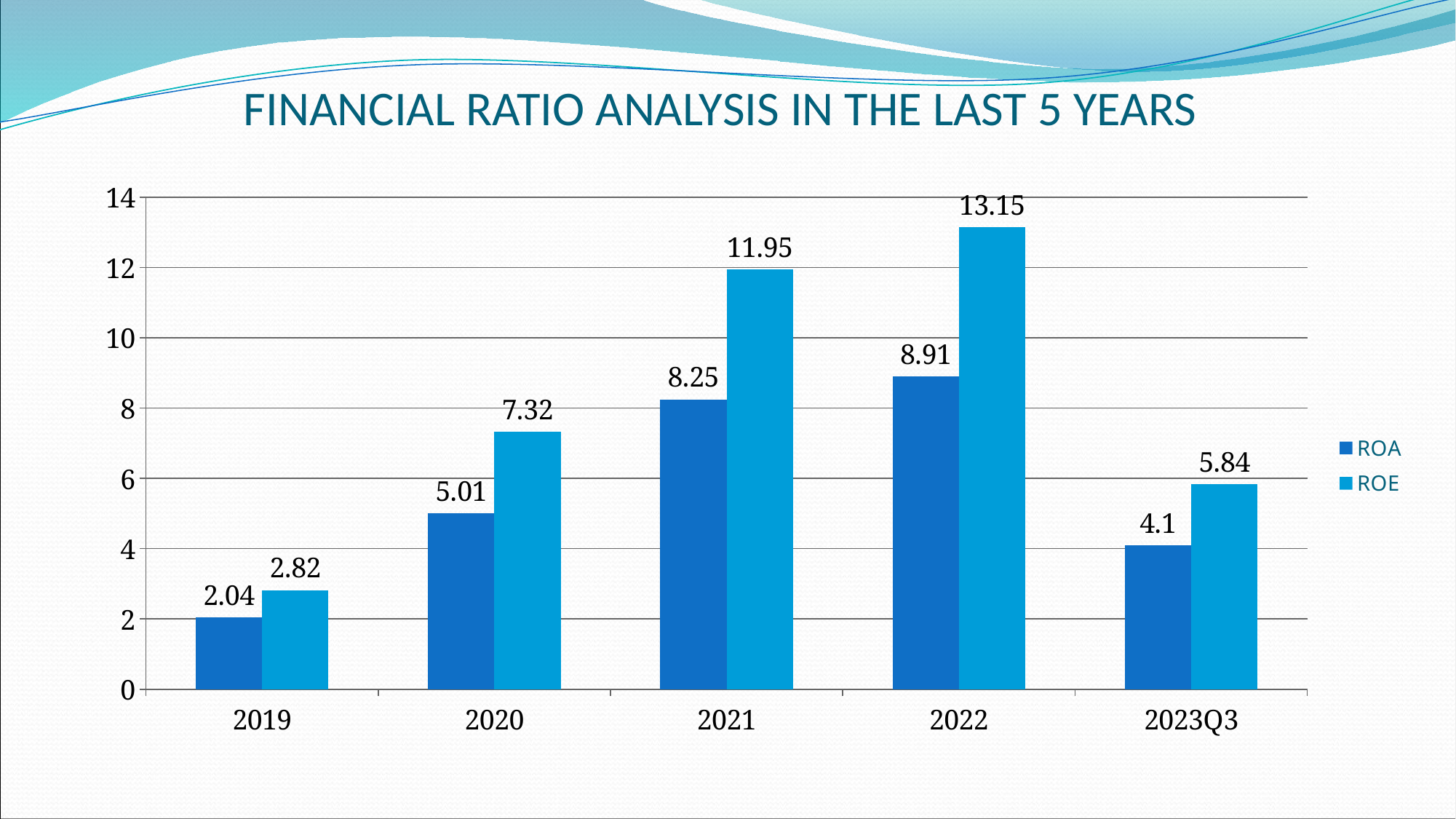
What is the title of the chart? FINANCIAL RATIO ANALYSIS IN THE LAST 5 YEARS How many series does the legend list? 2 Is the ROE value for 2019 greater or less than 4? less What kind of chart is shown on the slide? bar chart What is the ROA value for 2021? 8.25 In which year is ROE highest? 2022 In which year is ROA lowest? 2019 How many categories are shown on the x axis? 5 Which is larger, ROE in 2021 or ROE in 2023Q3? ROE in 2021 What is the ROA value for 2023Q3? 4.1 What is the ROE value for 2020? 7.32 What is the difference between ROE and ROA in 2022? 4.24